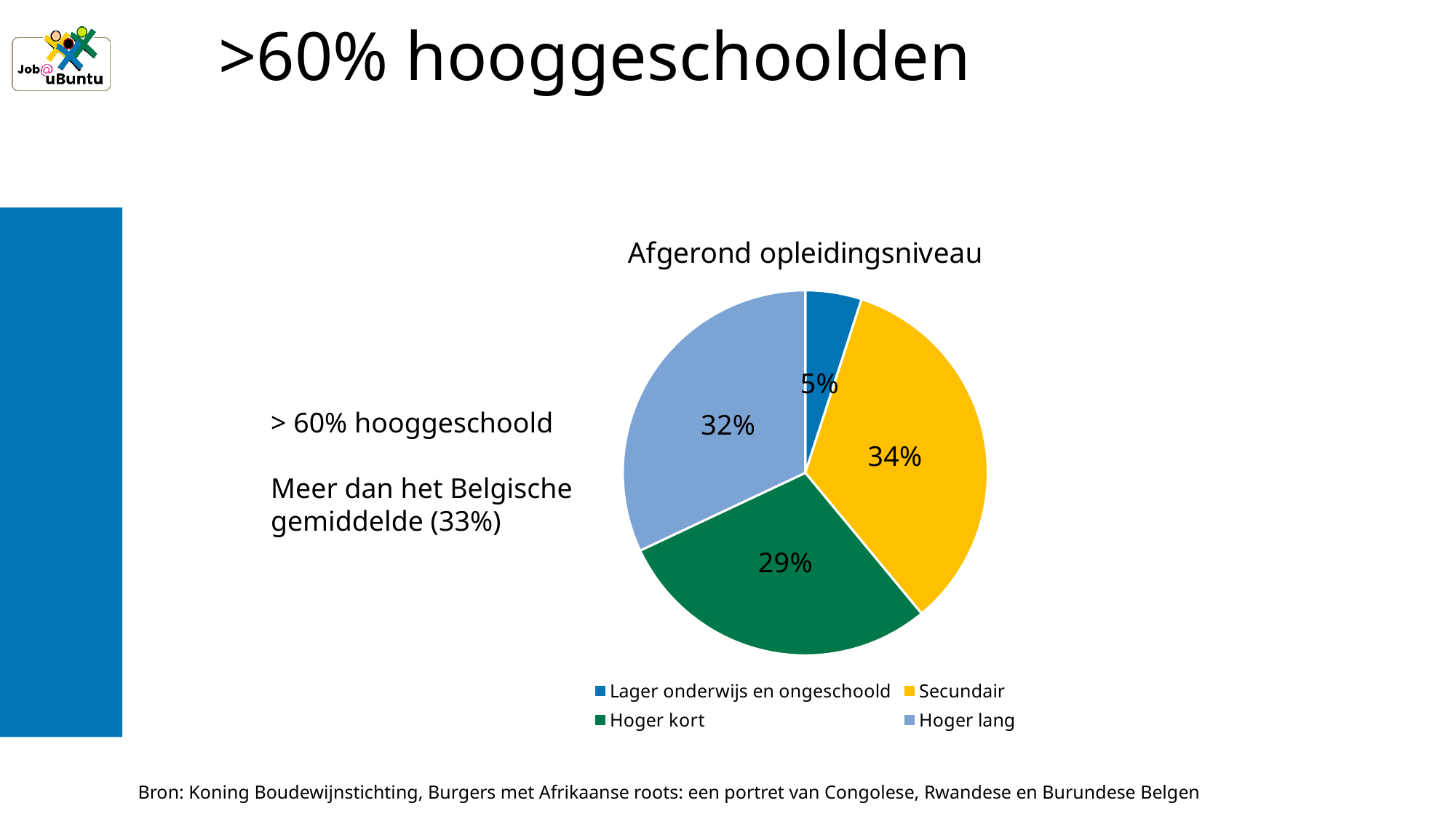
What share of the pie is Hoger kort? 29% What is the difference between the shares of Secundair and Hoger kort? 5% Which category has the smallest share of the pie? Lager onderwijs en ongeschoold What share of the pie is Secundair? 34% What share of the pie is Lager onderwijs en ongeschoold? 5% What type of chart is shown on the slide? pie chart What is the title of the chart? Afgerond opleidingsniveau How many categories does the pie chart have? 4 What share of the pie is Hoger lang? 32% What is the combined share of Hoger kort and Hoger lang? 61% Which category has the largest share of the pie? Secundair Which is larger, the share of Hoger lang or the share of Hoger kort? Hoger lang